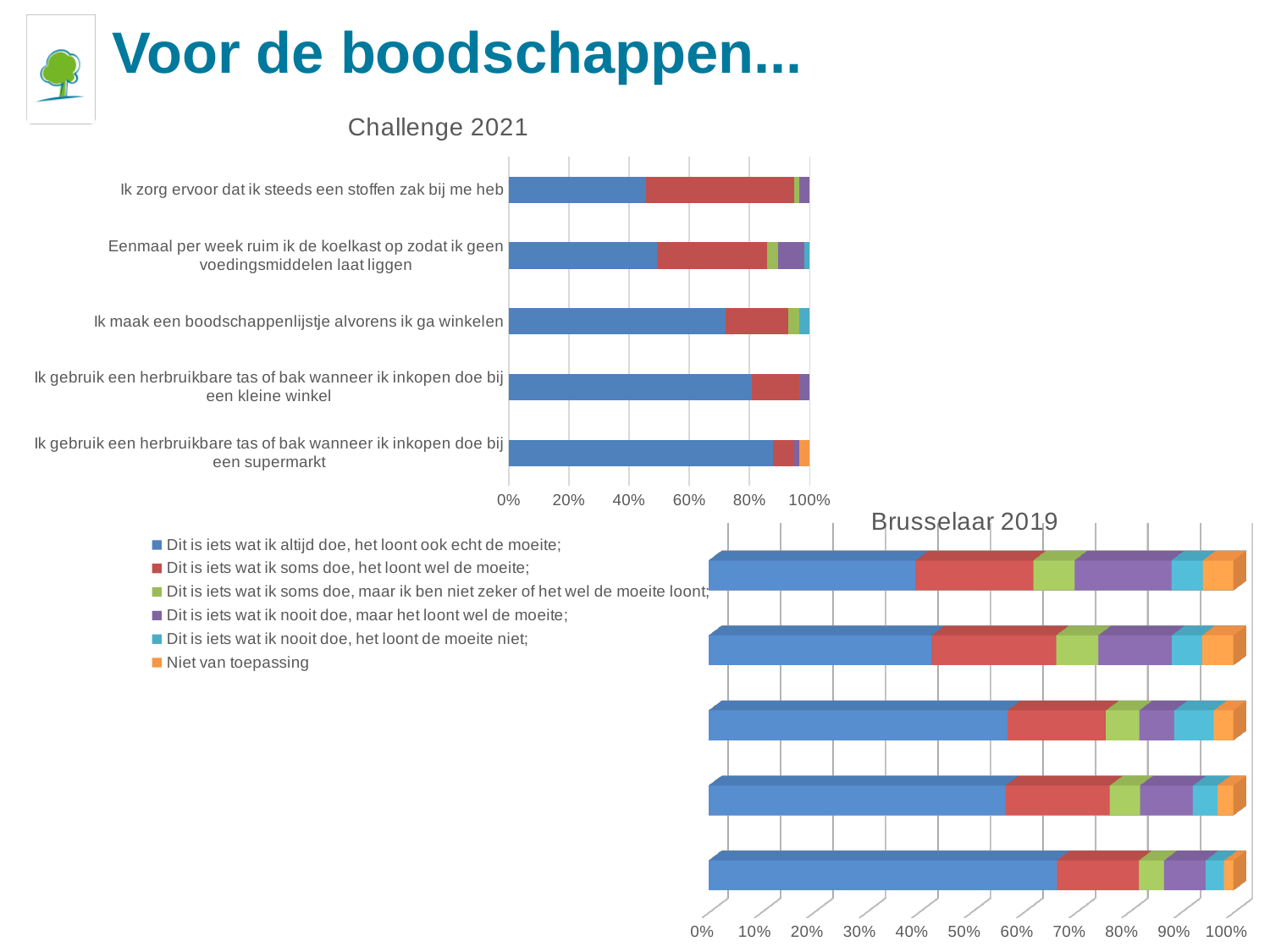
What is the title of the chart in the lower right of the slide? Brusselaar 2019 In the Brusselaar 2019 chart, is the blue segment of the bottom bar greater or less than 60%? greater How many series does the legend list for the Challenge 2021 chart? 6 In the Challenge 2021 chart, is the blue segment for "Ik gebruik een herbruikbare tas of bak wanneer ik inkopen doe bij een supermarkt" greater or less than 80%? greater What kind of chart is the Challenge 2021 chart? bar chart In the Challenge 2021 chart, is the blue segment for "Ik zorg ervoor dat ik steeds een stoffen zak bij me heb" greater or less than 60%? less In the Challenge 2021 chart, which category has the largest blue segment ("Dit is iets wat ik altijd doe, het loont ook echt de moeite")? Ik gebruik een herbruikbare tas of bak wanneer ik inkopen doe bij een supermarkt How many categories are shown in the Challenge 2021 chart? 5 How many bars are shown in the Brusselaar 2019 chart? 5 In the Challenge 2021 chart, which has a larger blue segment: "Ik maak een boodschappenlijstje alvorens ik ga winkelen" or "Eenmaal per week ruim ik de koelkast op zodat ik geen voedingsmiddelen laat liggen"? Ik maak een boodschappenlijstje alvorens ik ga winkelen